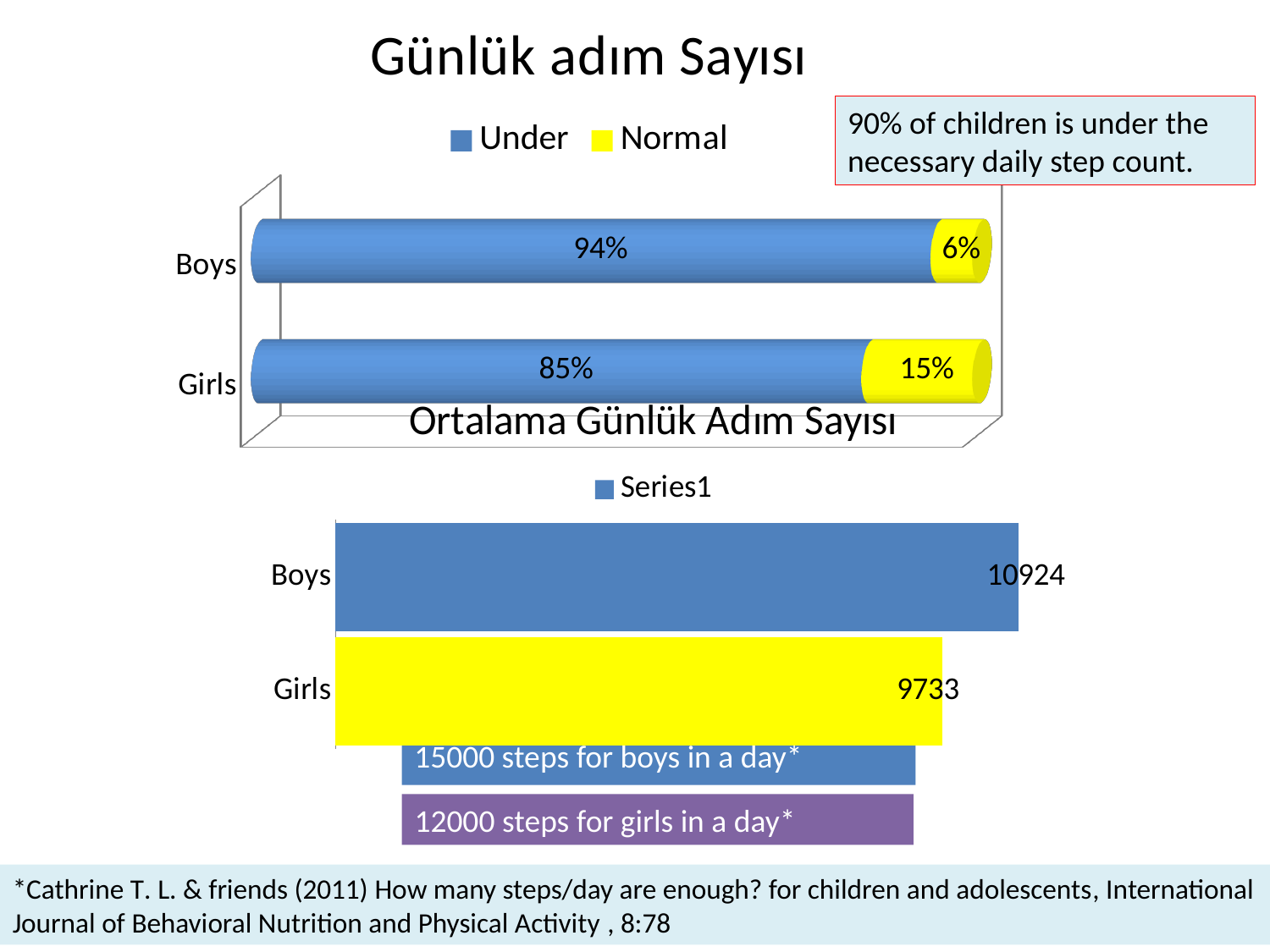
In the bottom chart (Ortalama Günlük Adım Sayısı), what is the value for Girls? 9733 In the bottom chart (Ortalama Günlük Adım Sayısı), what is the difference between the values for Boys and Girls? 1191 In the top chart (Günlük adım Sayısı), what is the 'Under' value for Boys? 94% What kind of chart is the bottom chart (Ortalama Günlük Adım Sayısı)? Bar chart In the top chart (Günlük adım Sayısı), what is the difference between the 'Under' values for Boys and Girls? 9% In the bottom chart (Ortalama Günlük Adım Sayısı), what is the value for Boys? 10924 In the top chart (Günlük adım Sayısı), what is the 'Normal' value for Girls? 15% In the top chart (Günlük adım Sayısı), how many series does the legend list? 2 In the bottom chart (Ortalama Günlük Adım Sayısı), which category has the lowest value? Girls In the top chart (Günlük adım Sayısı), what is the 'Normal' value for Boys? 6% In the top chart (Günlük adım Sayısı), which category has the higher 'Under' share, Boys or Girls? Boys In the top chart (Günlük adım Sayısı), what is the total of the stacked bar for Girls? 100%